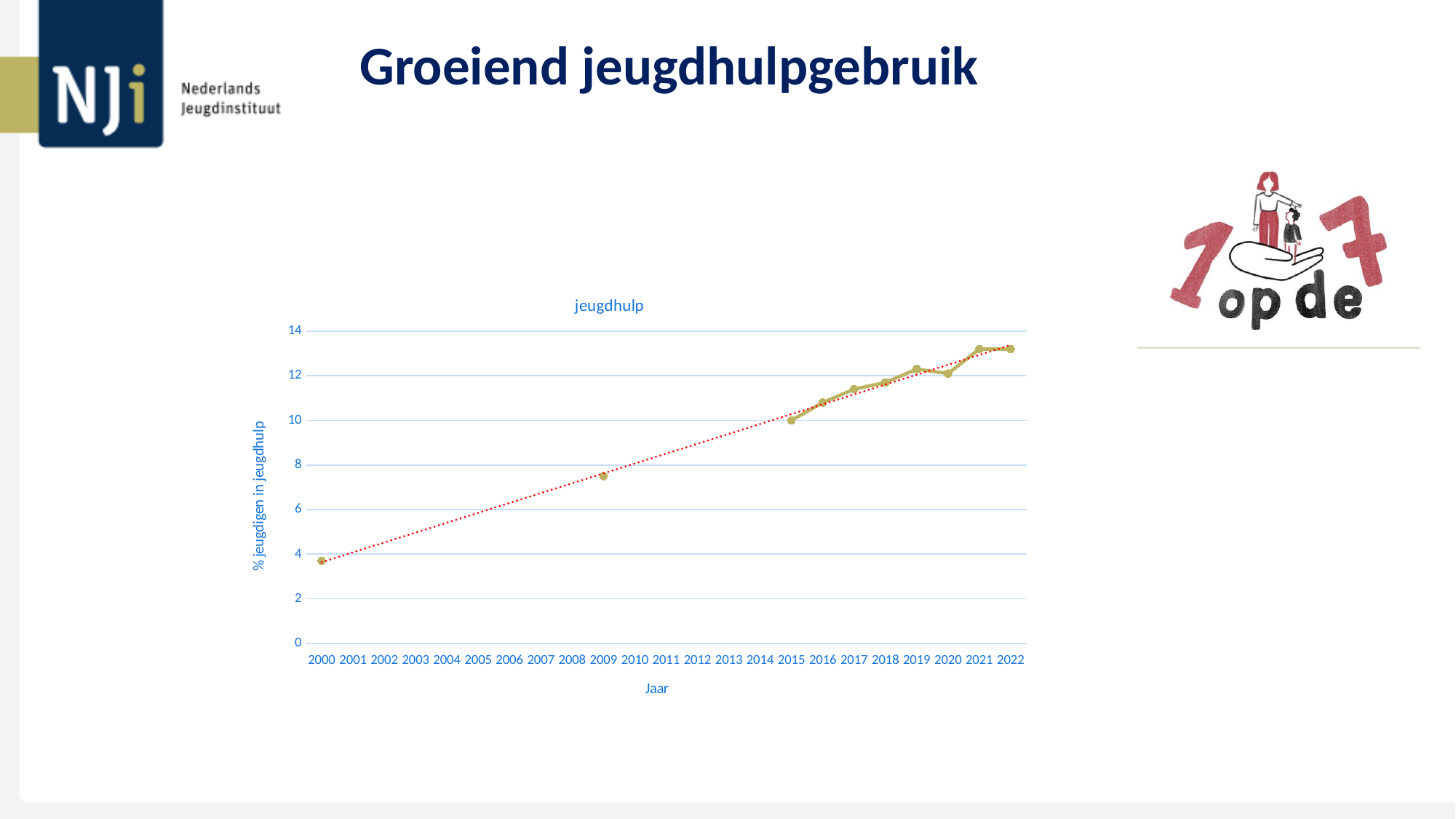
What kind of chart is shown on the slide? line chart Is the value for 2016 greater or less than 10? greater Which year has a higher value, 2000 or 2022? 2022 Is the value for 2009 greater or less than 8? less How many years are labelled on the x axis of the chart? 23 What is the label of the vertical axis of the chart? % jeugdigen in jeugdhulp Which year has the lowest value in the chart? 2000 Is the value for 2000 greater or less than 4? less Do the values in the chart rise or fall from 2000 to 2022? rise What is the title of the chart? jeugdhulp